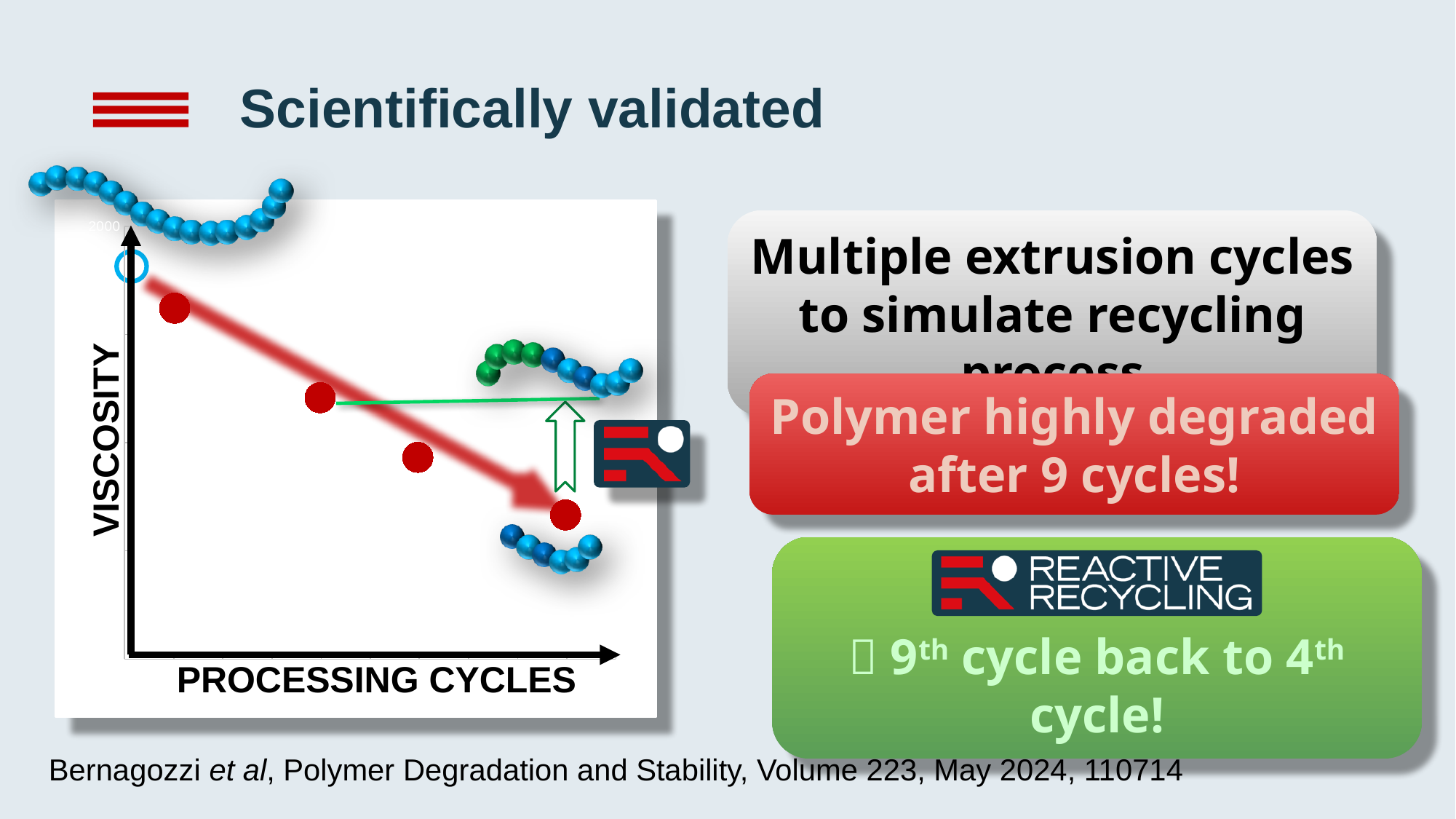
Which red point has the highest viscosity, the leftmost or the rightmost? the leftmost What kind of chart is shown on the slide? scatter chart How many red data points are plotted on the chart? 4 Is the viscosity of the first red point higher or lower than that of the last red point? higher What is the label on the horizontal axis of the chart? PROCESSING CYCLES What is the label on the vertical axis of the chart? VISCOSITY Do the plotted red points rise or fall as processing cycles increase? fall Which red point has the lowest viscosity, the leftmost or the rightmost? the rightmost